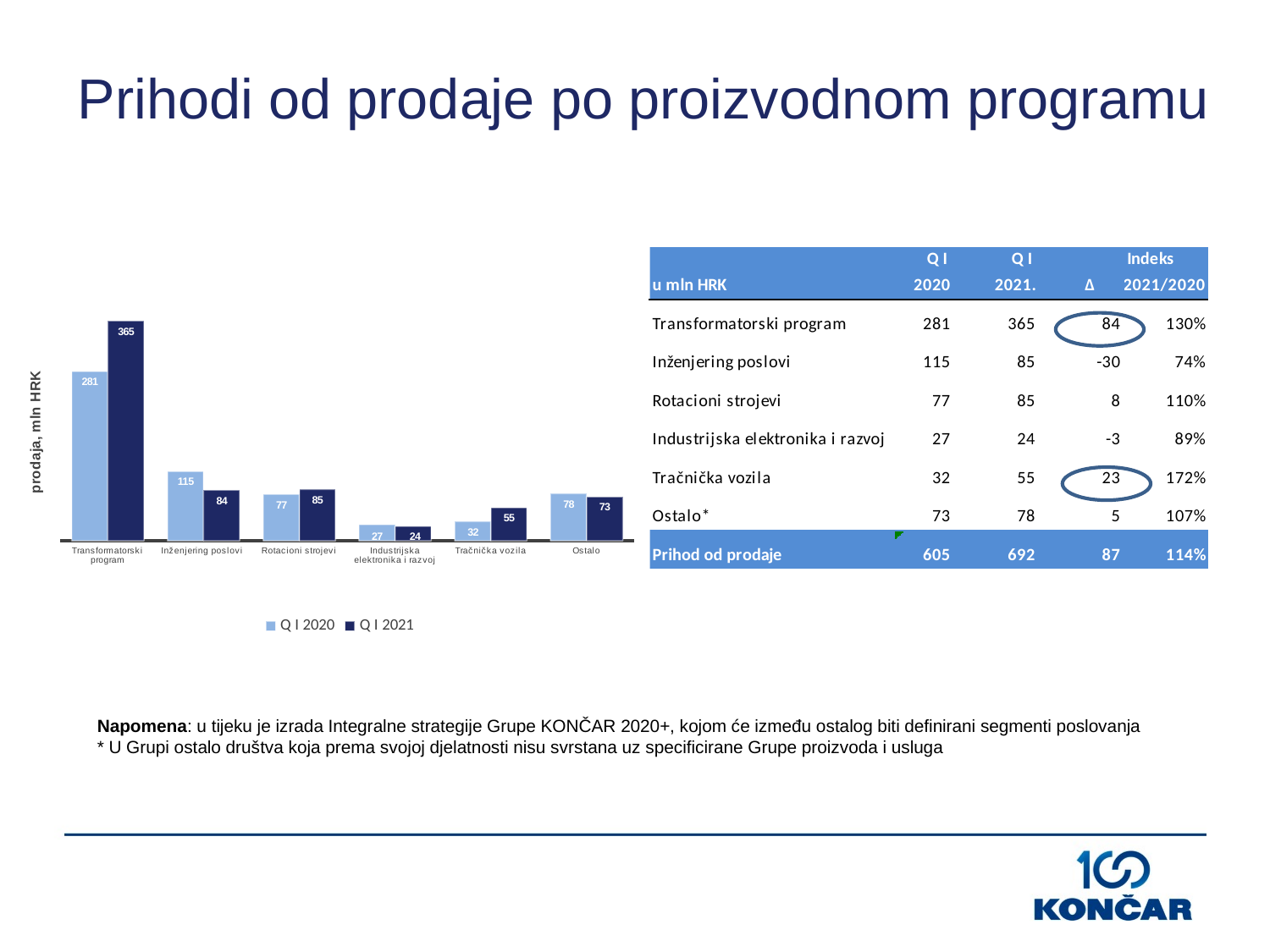
Which category has the lowest value in the Q I 2020 series? Industrijska elektronika i razvoj Which is larger for Tračnička vozila: the Q I 2020 value or the Q I 2021 value? Q I 2021 How many categories are shown on the x axis of the chart? 6 What is the value for Transformatorski program in the Q I 2020 series? 281 How many series does the chart legend list? 2 What kind of chart is shown on the slide? Bar chart What is the difference between the Q I 2021 and Q I 2020 values for Transformatorski program? 84 What is the value for Transformatorski program in the Q I 2021 series? 365 Which category has the highest value in the Q I 2021 series? Transformatorski program What is the value for Rotacioni strojevi in the Q I 2020 series? 77 What is the label of the chart's vertical axis? prodaja, mln HRK What is the value for Tračnička vozila in the Q I 2021 series? 55